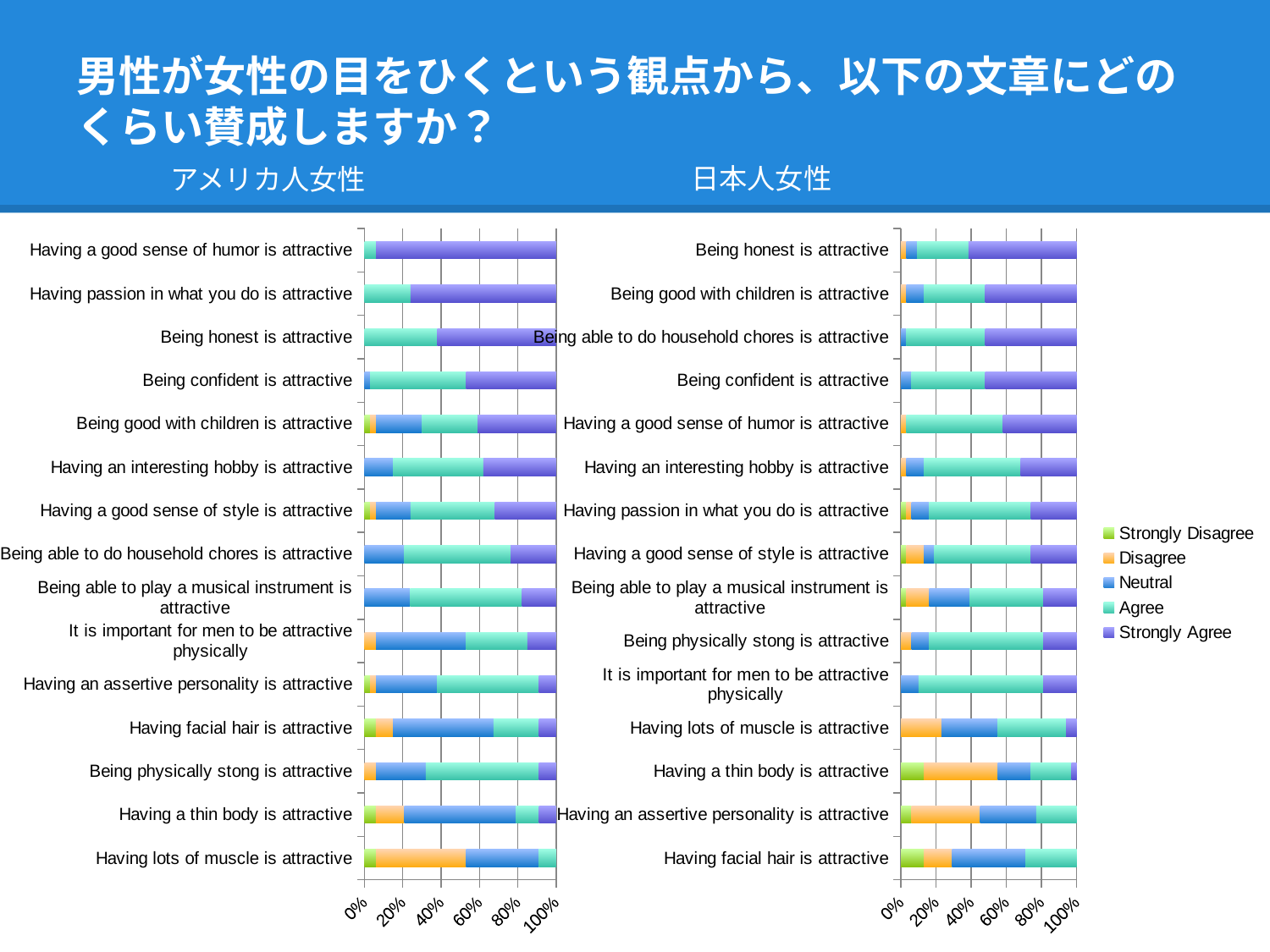
In the アメリカ人女性 chart on the left, is the Neutral value for 'Having a thin body is attractive' greater or less than 40%? greater How many categories are plotted in the 日本人女性 chart on the right? 15 In the アメリカ人女性 chart on the left, which category has the largest Strongly Agree segment? Having a good sense of humor is attractive Which legend entry is shown in orange? Disagree How many categories are plotted in the アメリカ人女性 chart on the left? 15 How many series does the legend list? 5 In the アメリカ人女性 chart on the left, is the Agree value for 'Having lots of muscle is attractive' greater or less than 20%? less What kind of chart is used for the アメリカ人女性 chart on the left? stacked bar chart In the 日本人女性 chart on the right, which category has the largest Strongly Agree segment? Being honest is attractive In the アメリカ人女性 chart on the left, is the Strongly Agree value for 'Having a good sense of humor is attractive' greater or less than 80%? greater In the アメリカ人女性 chart on the left, which category has the largest Disagree segment? Having lots of muscle is attractive